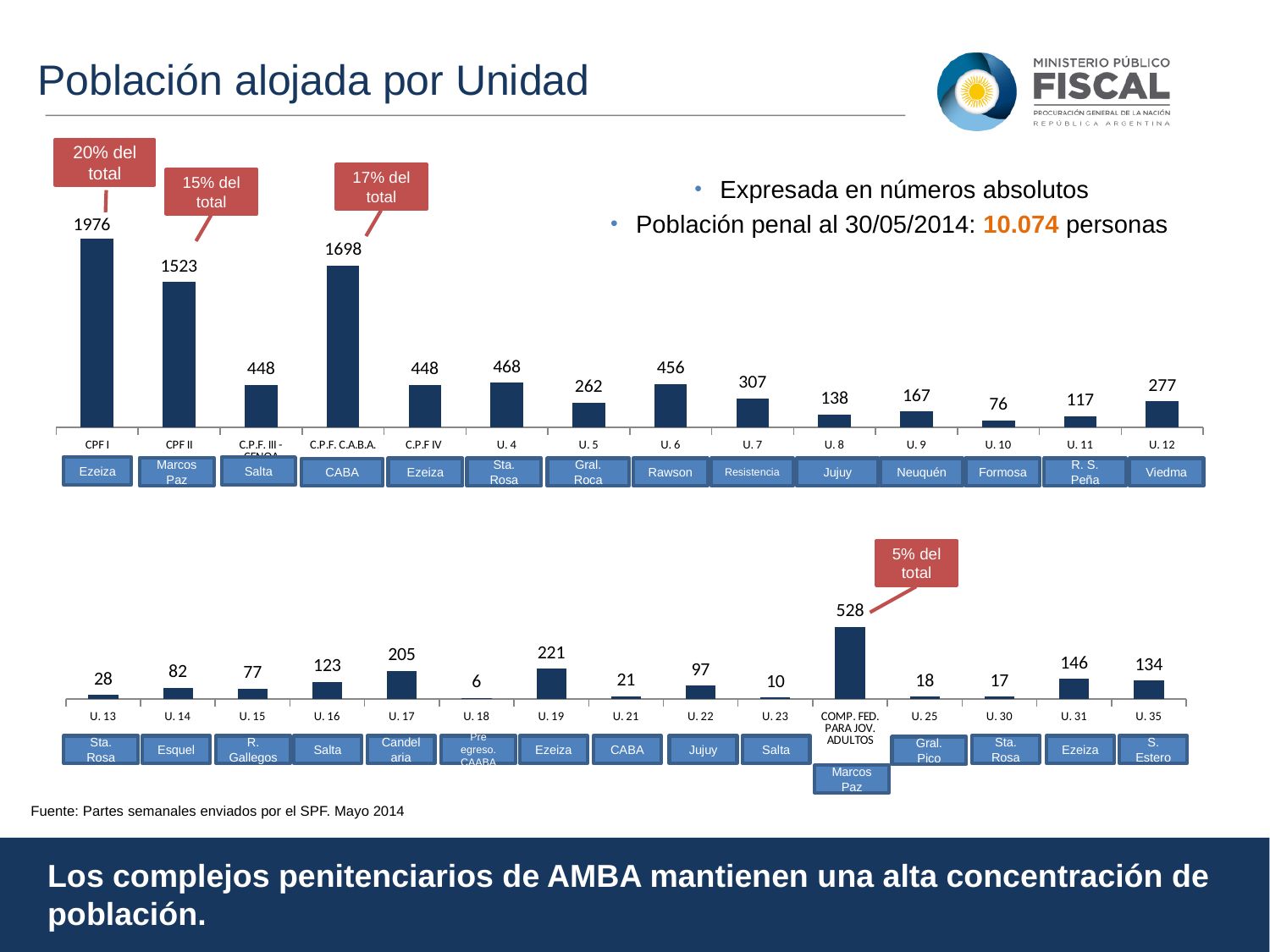
In the bottom chart, which unit has the highest value? COMP. FED. PARA JOV. ADULTOS How many units are shown in the top chart? 14 In the top chart, what is the value for U. 7? 307 In the top chart, which is larger, the value for U. 4 or the value for U. 5? U. 4 In the top chart, which unit has the highest value? CPF I In the bottom chart, what is the value for U. 19? 221 In the top chart, what is the difference between the values for CPF I and CPF II? 453 In the bottom chart, which unit has the lowest value? U. 18 In the bottom chart, what is the difference between the values for U. 31 and U. 35? 12 In the top chart, which unit has the lowest value? U. 10 In the top chart, what is the value for CPF I? 1976 What type of chart is the bottom chart? Bar chart